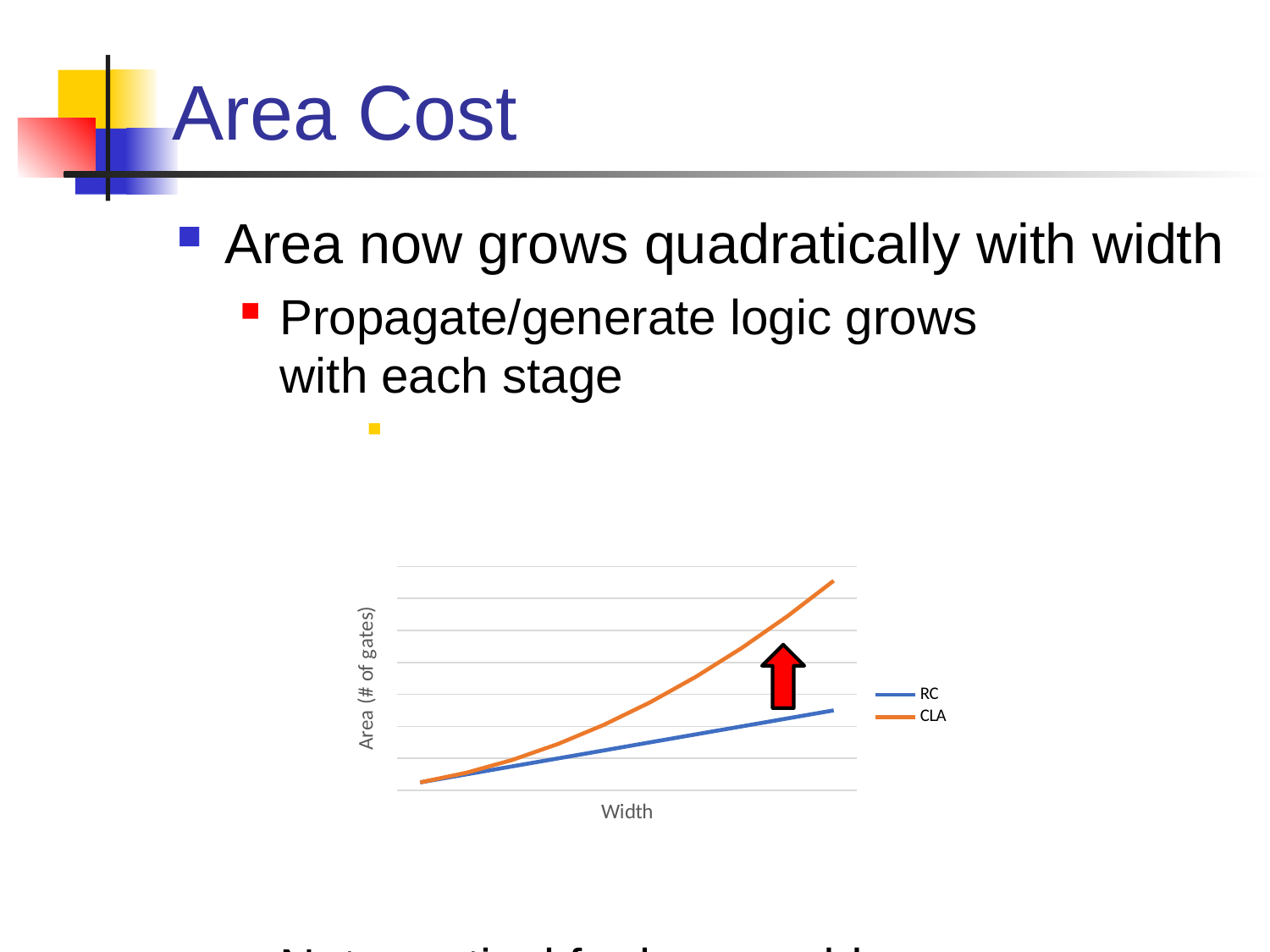
Does the CLA series rise or fall as width increases? rise Which series has the lowest area at the right end of the chart? RC Does the RC series rise or fall as width increases? rise How many series does the chart's legend list? 2 Which series grows faster with width, RC or CLA? CLA What is the label of the chart's x axis? Width At the largest width shown, which series has the higher area: RC or CLA? CLA Which series reaches the highest area value on the chart? CLA What kind of chart is shown on the slide? line chart What are the names of the two series in the chart's legend? RC and CLA